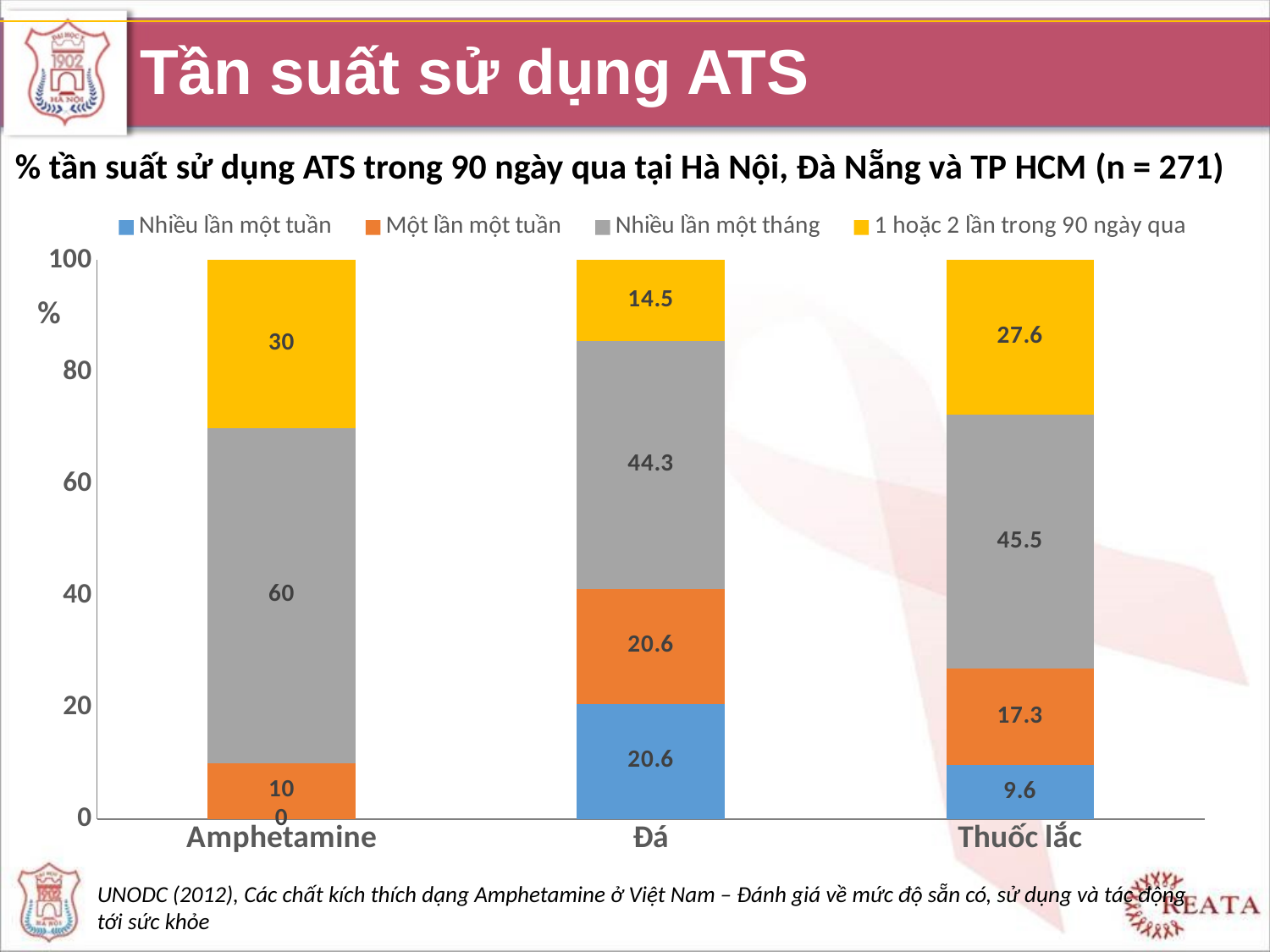
Which category has the highest value for "Nhiều lần một tháng"? Amphetamine What is the total of the stacked bar for Đá? 100 How many series does the legend list? 4 What is the value of "Một lần một tuần" for Thuốc lắc? 17.3 Which is larger: the "Một lần một tuần" value for Đá or for Thuốc lắc? Đá What kind of chart is shown on the slide? Stacked bar chart Which category has the lowest value for "1 hoặc 2 lần trong 90 ngày qua"? Đá What is the value of "Nhiều lần một tuần" for Đá? 20.6 What is the value of "1 hoặc 2 lần trong 90 ngày qua" for Thuốc lắc? 27.6 What is the difference between the "Nhiều lần một tháng" values for Thuốc lắc and Đá? 1.2 How many categories are shown on the x axis? 3 What is the value of "Nhiều lần một tháng" for Amphetamine? 60